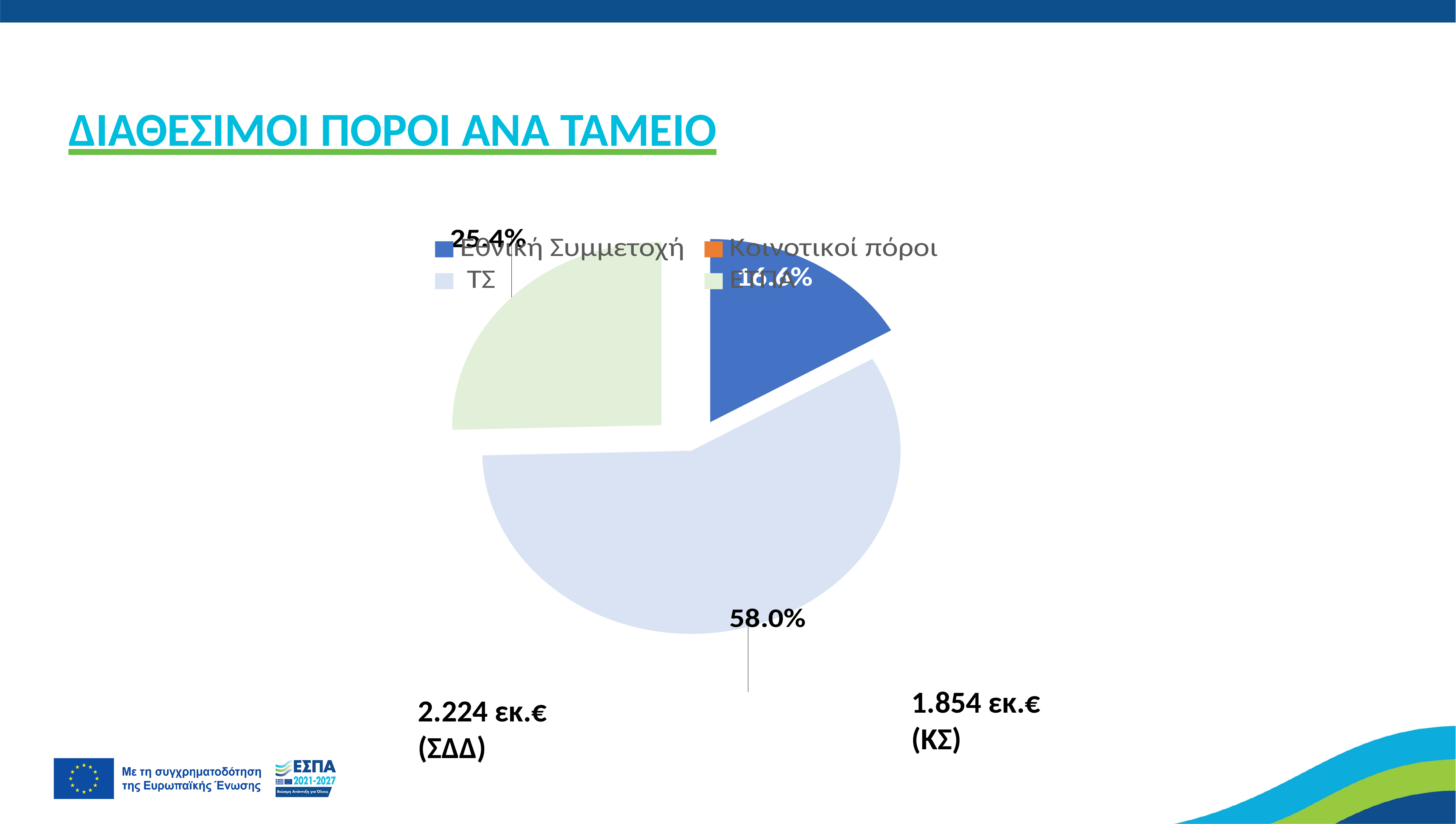
What is the title of the chart on the slide? ΔΙΑΘΕΣΙΜΟΙ ΠΟΡΟΙ ΑΝΑ ΤΑΜΕΙΟ What kind of chart is shown on the slide? pie chart Is the share for ΤΣ greater or less than 50%? greater What share of the pie does ΕΤΠΑ represent? 25.4% What share of the pie does ΤΣ represent? 58.0% How many slices are visible in the pie chart? 3 What share of the pie does Εθνική Συμμετοχή represent? 16.6% What is the difference in percentage points between the ΤΣ slice and the ΕΤΠΑ slice? 32.6% Which slice is larger, ΕΤΠΑ or Εθνική Συμμετοχή? ΕΤΠΑ Which category has the largest slice of the pie? ΤΣ What colour is the ΤΣ slice in the pie chart? light blue How many entries does the chart's legend list? 4